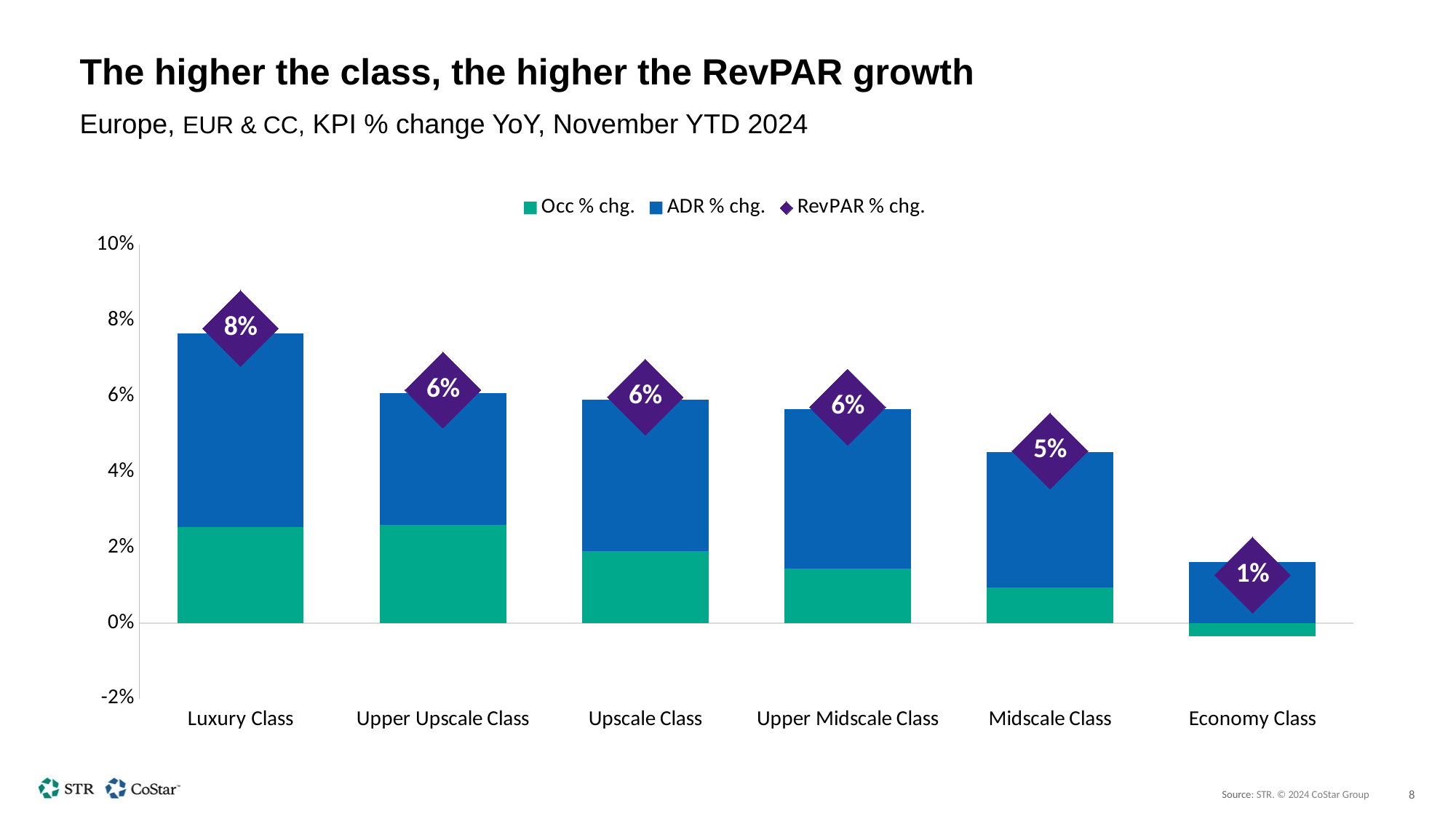
What is the RevPAR % chg. value for Luxury Class? 8% What is the RevPAR % chg. value for Midscale Class? 5% Which class has the highest RevPAR % chg.? Luxury Class What is the difference between the RevPAR % chg. for Luxury Class and Economy Class? 7% Is the Occ % chg. value for Economy Class greater or less than 0%? less How many series does the legend list? 3 Is the Occ % chg. value for Luxury Class greater or less than 2%? greater How many hotel classes are shown on the x axis? 6 Does the RevPAR % chg. rise or fall moving from Luxury Class to Economy Class along the x axis? fall What is the RevPAR % chg. value for Economy Class? 1% Which has a larger RevPAR % chg., Luxury Class or Midscale Class? Luxury Class Which class has the lowest RevPAR % chg.? Economy Class